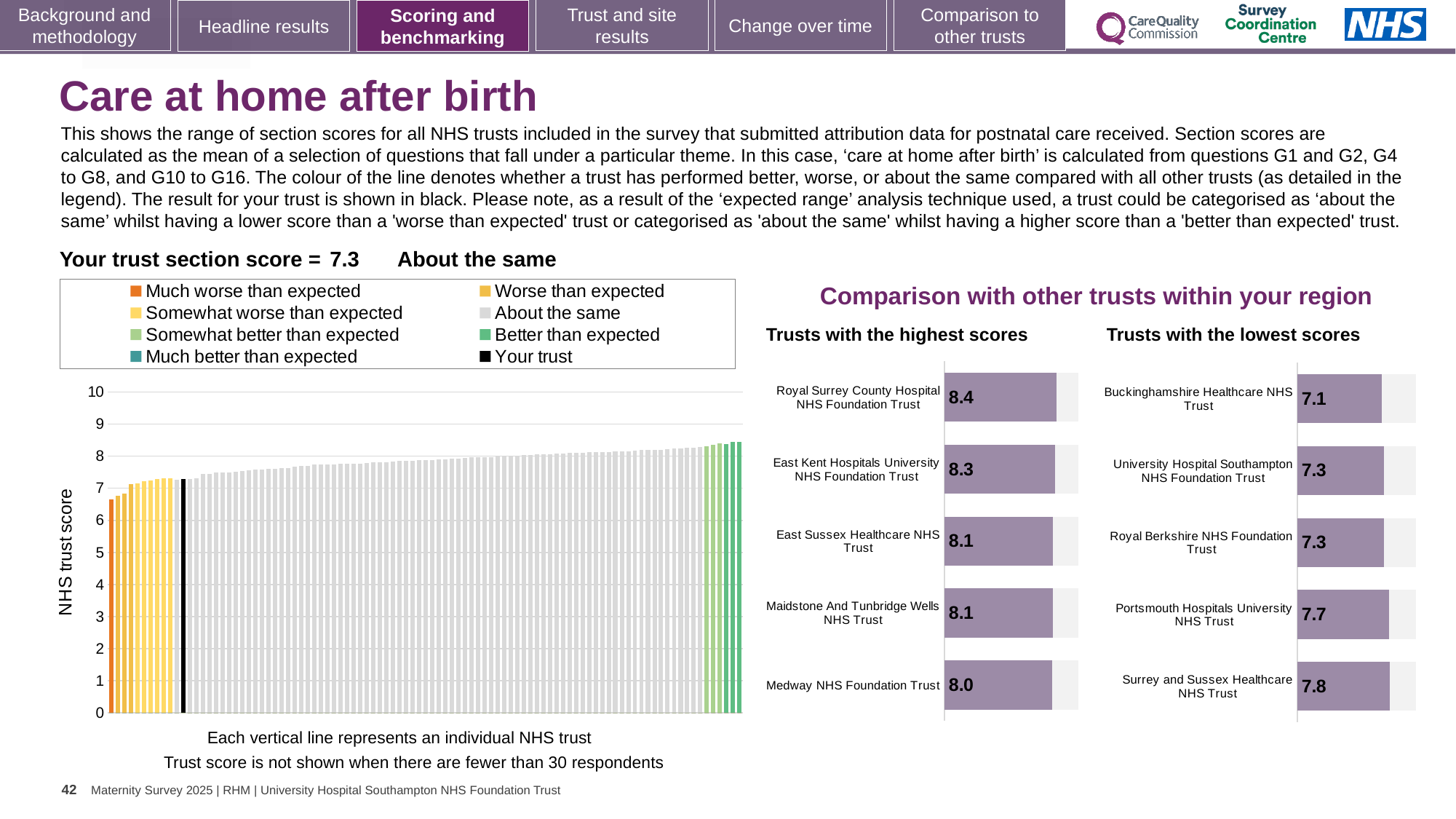
In the 'Trusts with the lowest scores' chart, which has the larger score: Portsmouth Hospitals University NHS Trust or Surrey and Sussex Healthcare NHS Trust? Surrey and Sussex Healthcare NHS Trust How many entries does the legend above the 'NHS trust score' chart list? 8 In the 'Trusts with the highest scores' chart, what is the difference between the scores of Royal Surrey County Hospital NHS Foundation Trust and Medway NHS Foundation Trust? 0.4 In the 'Trusts with the lowest scores' chart, what is the difference between the scores of Surrey and Sussex Healthcare NHS Trust and Buckinghamshire Healthcare NHS Trust? 0.7 In the 'NHS trust score' chart on the left, do the values rise or fall from left to right? rise How many trusts are shown in the 'Trusts with the highest scores' chart? 5 In the 'Trusts with the highest scores' chart, which trust has the highest score? Royal Surrey County Hospital NHS Foundation Trust In the 'Trusts with the lowest scores' chart, which trust has the lowest score? Buckinghamshire Healthcare NHS Trust What is the section score for your trust shown on the slide? 7.3 In the 'Trusts with the lowest scores' chart, what is the score for Buckinghamshire Healthcare NHS Trust? 7.1 In the 'Trusts with the highest scores' chart, what is the score for Royal Surrey County Hospital NHS Foundation Trust? 8.4 What kind of chart is the 'NHS trust score' chart on the left of the slide? bar chart